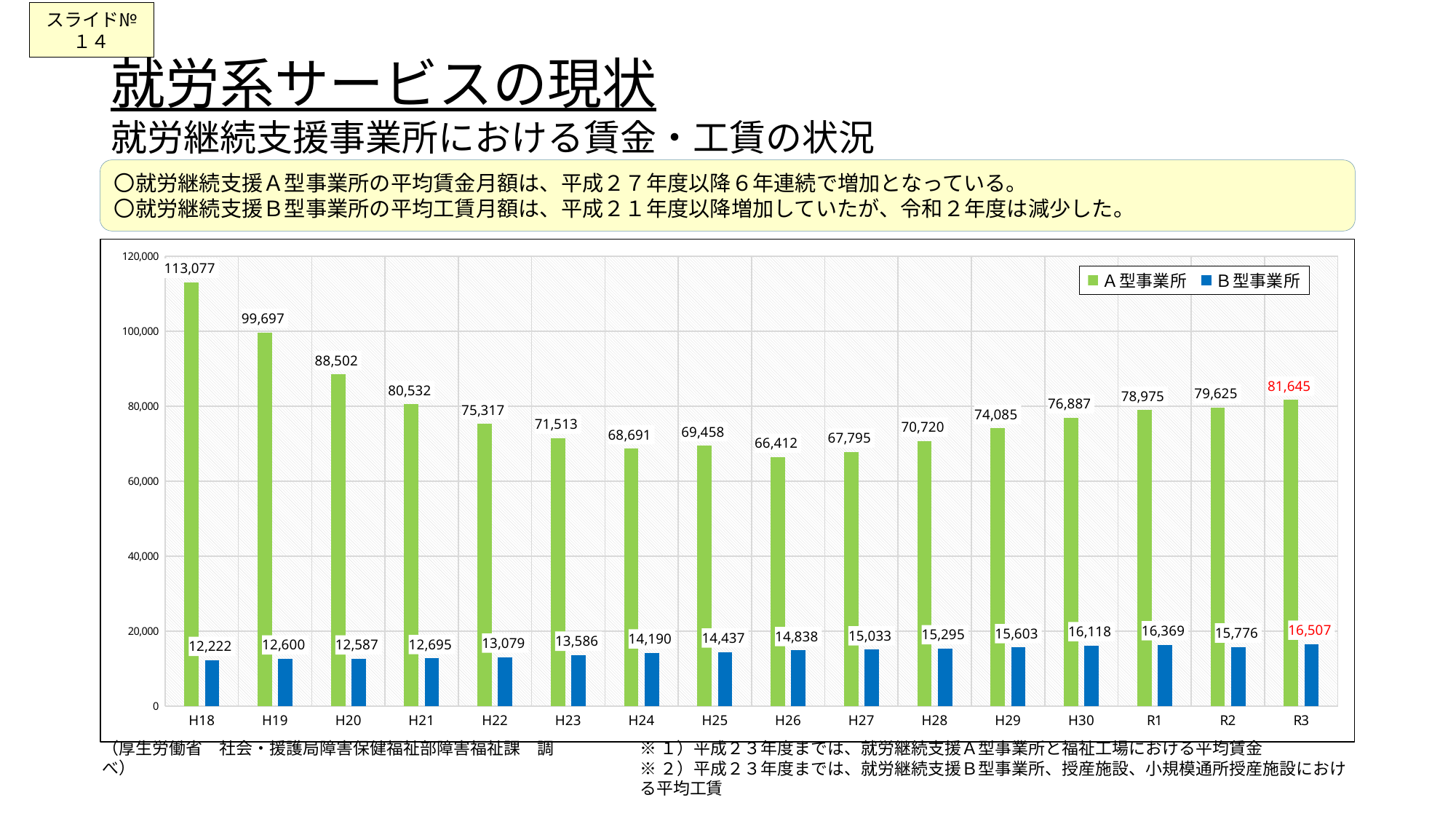
What is the value for A型事業所 in H18? 113,077 What kind of chart is shown on the slide? bar chart Is the A型事業所 value for H20 greater or less than 80,000? greater What is the difference between the A型事業所 values for R3 and R2? 2,020 How many years (categories) are shown on the x axis? 16 What is the value for B型事業所 in R3? 16,507 Do the A型事業所 values rise or fall from H18 to H24? fall In which year is the A型事業所 value highest? H18 Which is larger, the B型事業所 value for R1 or for R2? R1 In which year is the B型事業所 value lowest? H18 In which year is the A型事業所 value lowest? H26 How many series does the legend list? 2